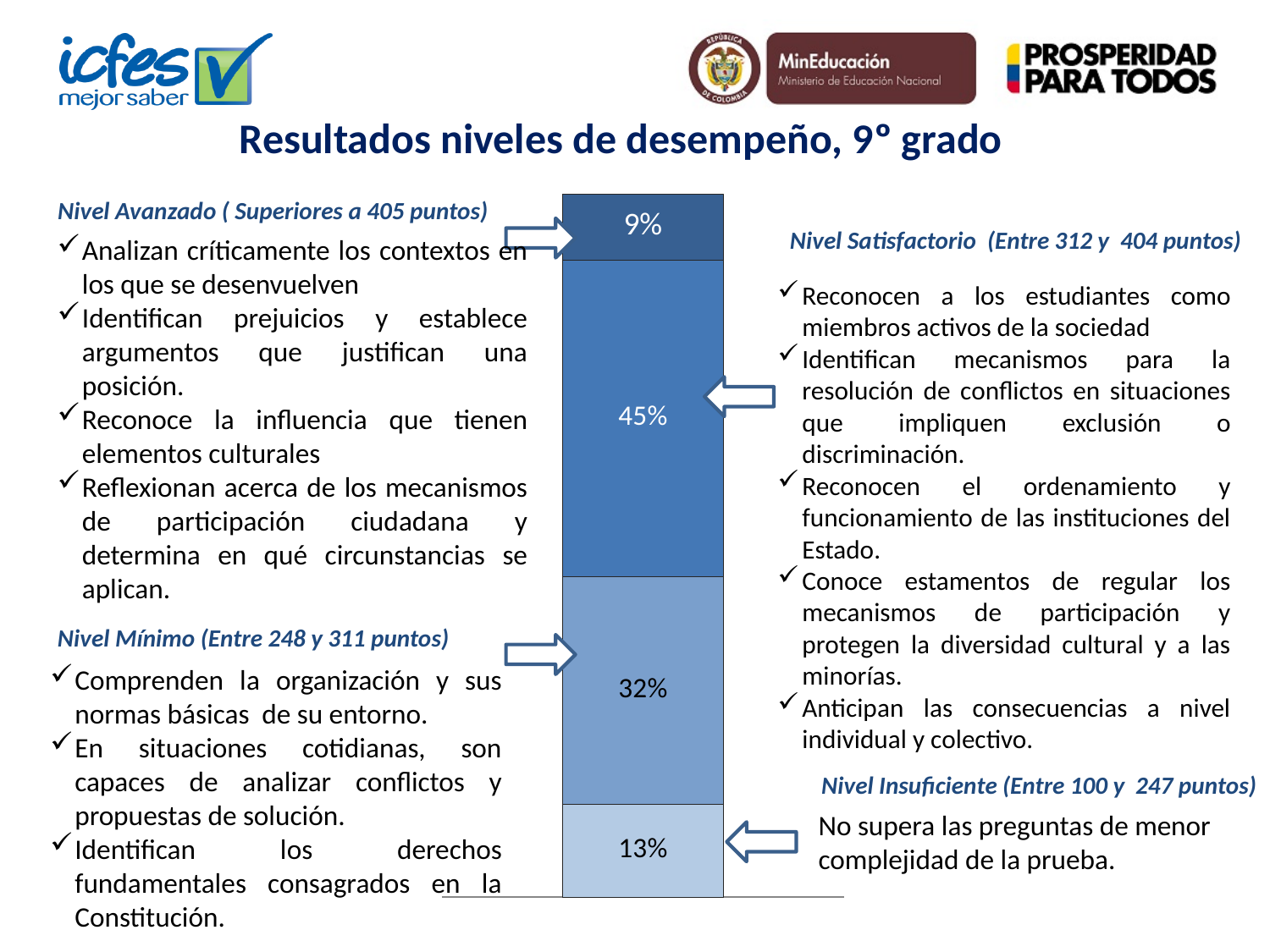
Which performance level has the smallest share in the stacked bar? Nivel Avanzado What is the difference in percentage points between Nivel Insuficiente and Nivel Avanzado? 4 What percentage of students are at Nivel Avanzado according to the stacked bar? 9% How many segments does the stacked bar contain? 4 Which is larger, the share for Nivel Mínimo or the share for Nivel Insuficiente? Nivel Mínimo What is the title of the slide containing the chart? Resultados niveles de desempeño, 9° grado What percentage of students are at Nivel Mínimo according to the stacked bar? 32% What percentage of students are at Nivel Insuficiente according to the stacked bar? 13% What percentage of students are at Nivel Satisfactorio according to the stacked bar? 45% Which performance level has the largest share in the stacked bar? Nivel Satisfactorio What is the difference in percentage points between Nivel Satisfactorio and Nivel Mínimo? 13 What kind of chart is shown on the slide? Stacked bar chart